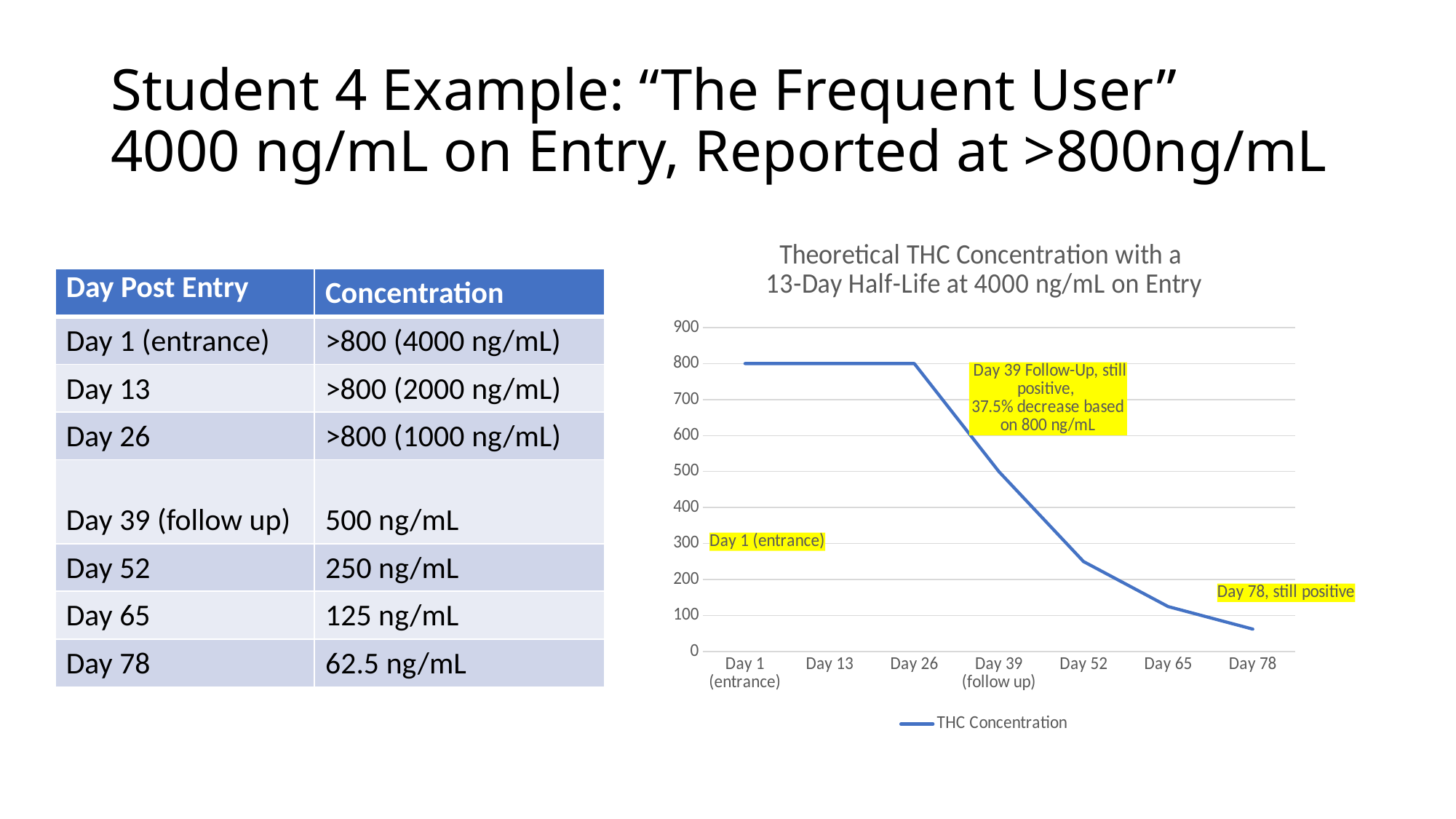
Is the plotted value for Day 78 greater or less than 100? less How many data points are plotted on the line chart? 7 Which has the higher plotted value, Day 39 (follow up) or Day 52? Day 39 (follow up) Is the plotted value for Day 65 greater or less than 200? less What is the difference between the plotted values at Day 26 and Day 39 (follow up)? 300 What is the plotted THC concentration at Day 39 (follow up)? 500 How many series does the chart legend list? 1 What is the plotted THC concentration at Day 26? 800 What kind of chart is shown on the slide? line chart Do the plotted values rise or fall from Day 26 to Day 78? fall Is the plotted value for Day 52 greater or less than 300? less Which day has the lowest plotted THC concentration? Day 78